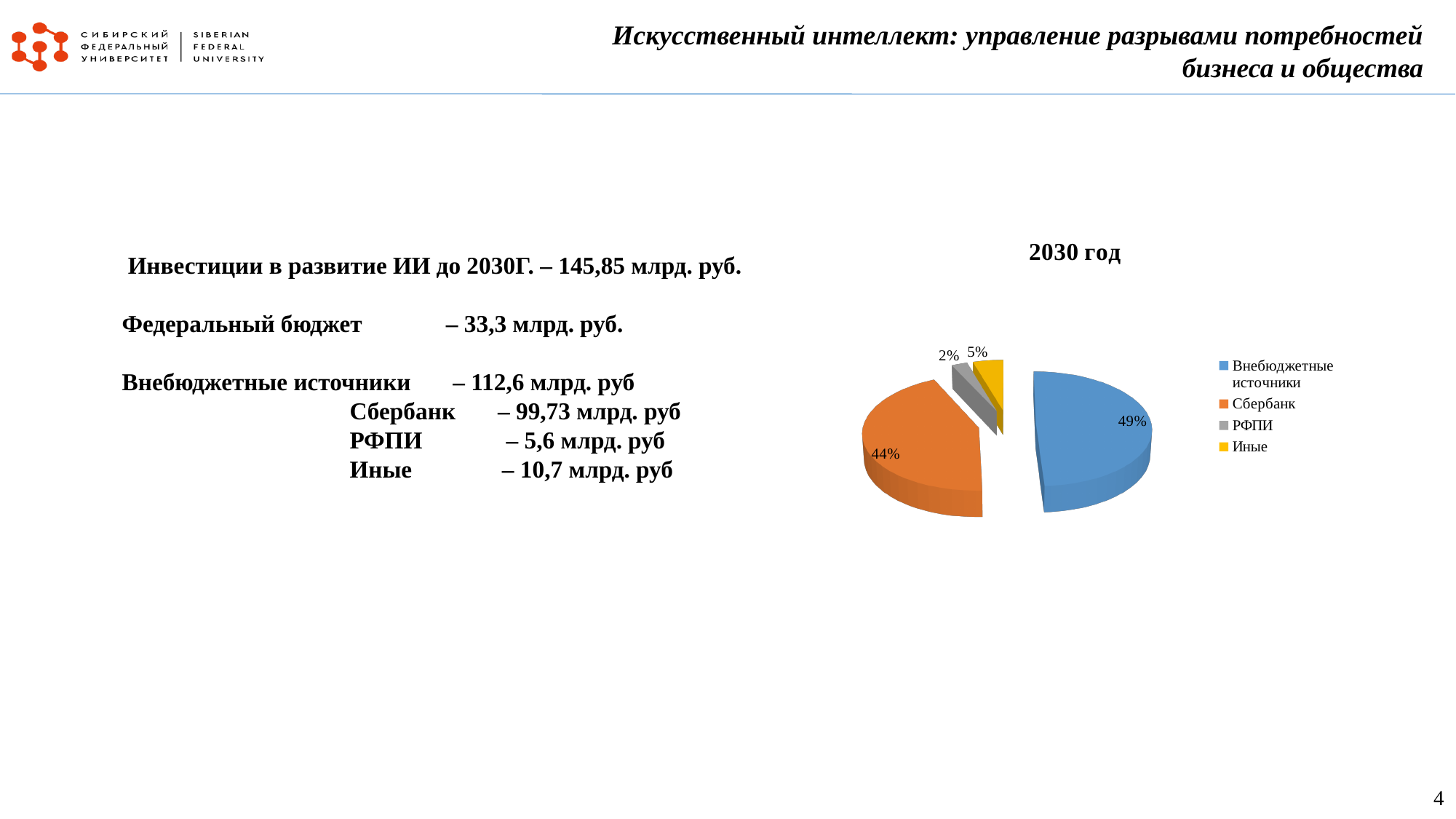
What is the difference in percentage points between the Внебюджетные источники slice and the Сбербанк slice? 5% What kind of chart is shown on the slide? pie chart Which slice is larger, Иные or РФПИ? Иные What is the title of the pie chart? 2030 год What share of the pie does Сбербанк have? 44% What share of the pie does РФПИ have? 2% Which slice of the pie chart is the largest? Внебюджетные источники How many entries does the legend of the pie chart list? 4 How many slices does the pie chart have? 4 What share of the pie does Внебюджетные источники have? 49% Which slice of the pie chart is the smallest? РФПИ